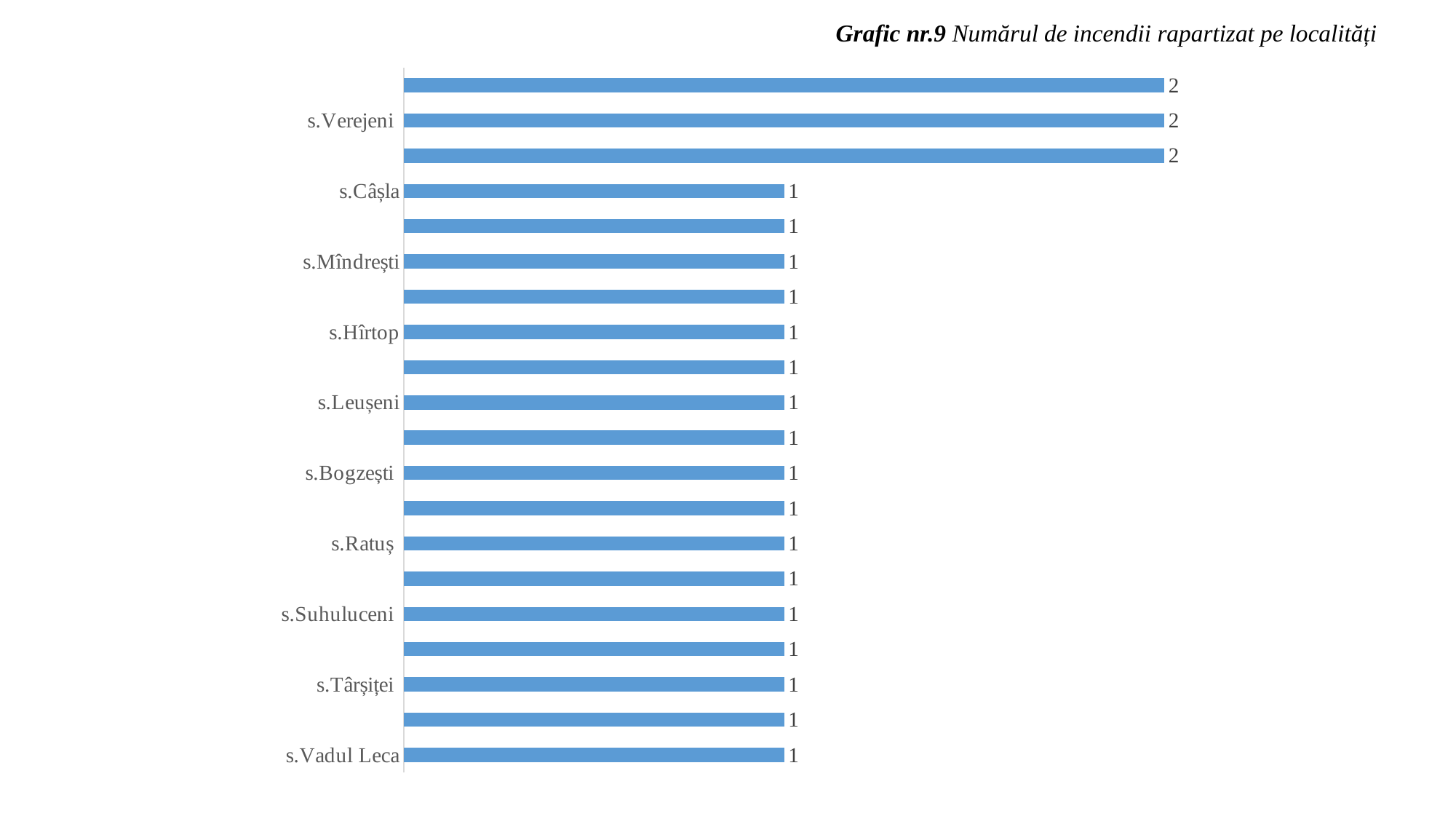
What is the value for s.Suhuluceni? 1 What is the highest value shown by any bar in the chart? 2 Which has the larger value, s.Verejeni or s.Bogzești? s.Verejeni What kind of chart is shown on the slide? bar chart What colour are the bars in the chart? blue What is the value for s.Verejeni? 2 What is the value for s.Hîrtop? 1 What is the difference between the values for s.Verejeni and s.Ratuș? 1 What is the title of the chart? Grafic nr.9 Numărul de incendii rapartizat pe localități What is the value for s.Vadul Leca? 1 What is the value for s.Câșla? 1 How many bars are plotted in the chart? 20